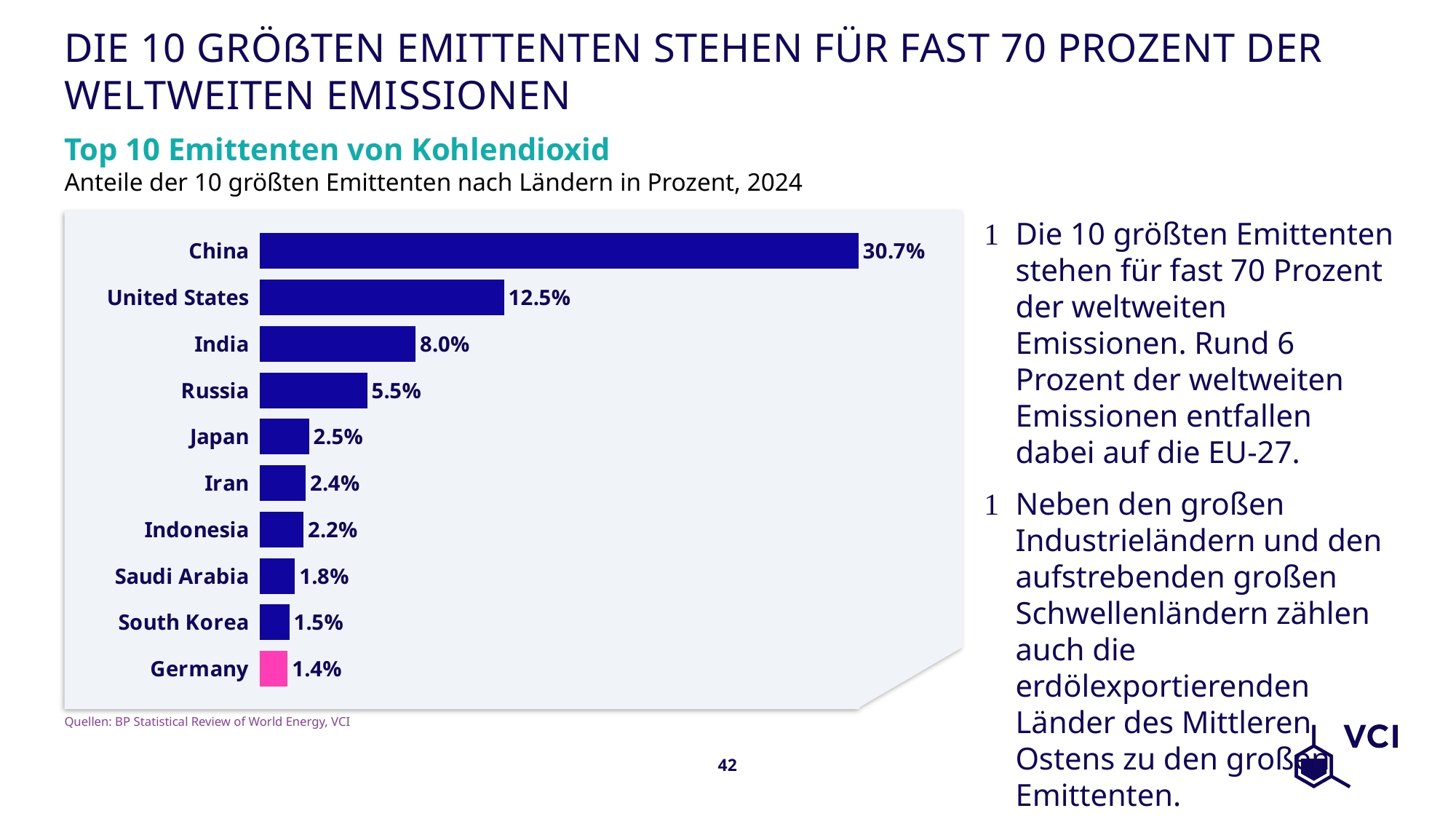
Which is larger, the value for Iran or the value for Indonesia? Iran What is the value for Germany? 1.4% How many countries are shown in the chart? 10 What is the value for China? 30.7% What is the value for India? 8.0% What kind of chart is this? Bar chart What is the difference between the values for China and the United States? 18.2% Which country's bar is shown in a different colour (pink) from the others? Germany Which country has the lowest share? Germany Which country has the highest share? China What is the difference between the values for Russia and Japan? 3.0% What is the title of the chart? Top 10 Emittenten von Kohlendioxid